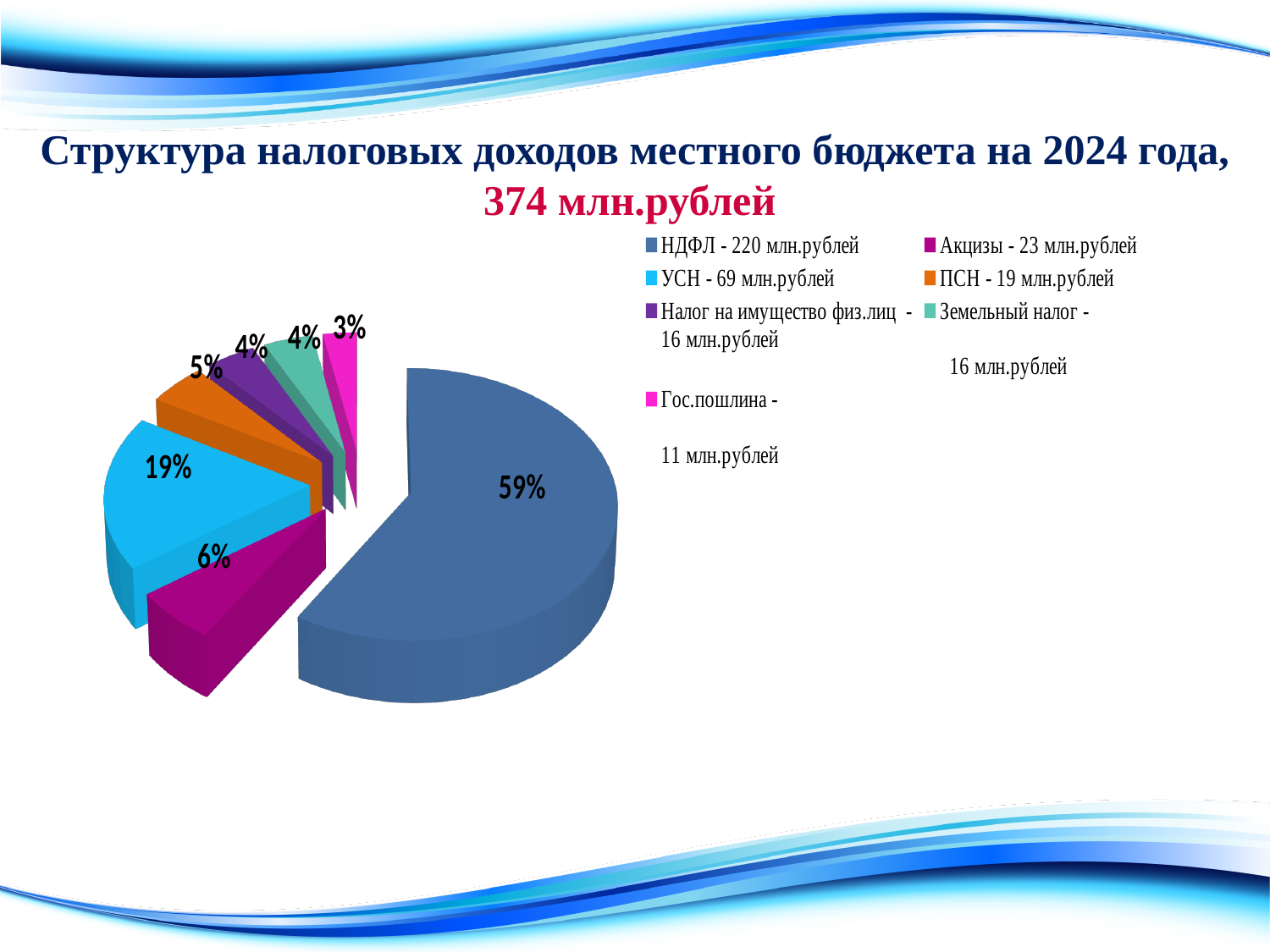
What share of the pie does УСН account for? 19% Which category has the smallest slice of the pie? Гос.пошлина By how much does the value for НДФЛ exceed the value for УСН, according to the legend? 151 млн.рублей According to the legend, what is the value for Гос.пошлина? 11 млн.рублей Which is larger, the value for УСН or the value for Акцизы? УСН What share of the pie does НДФЛ account for? 59% What total amount is stated in the chart title? 374 млн.рублей According to the legend, what is the value for Акцизы? 23 млн.рублей What kind of chart is shown on the slide? pie chart How many slices does the pie chart have? 7 What share of the pie does ПСН account for? 5% Which category has the largest slice of the pie? НДФЛ